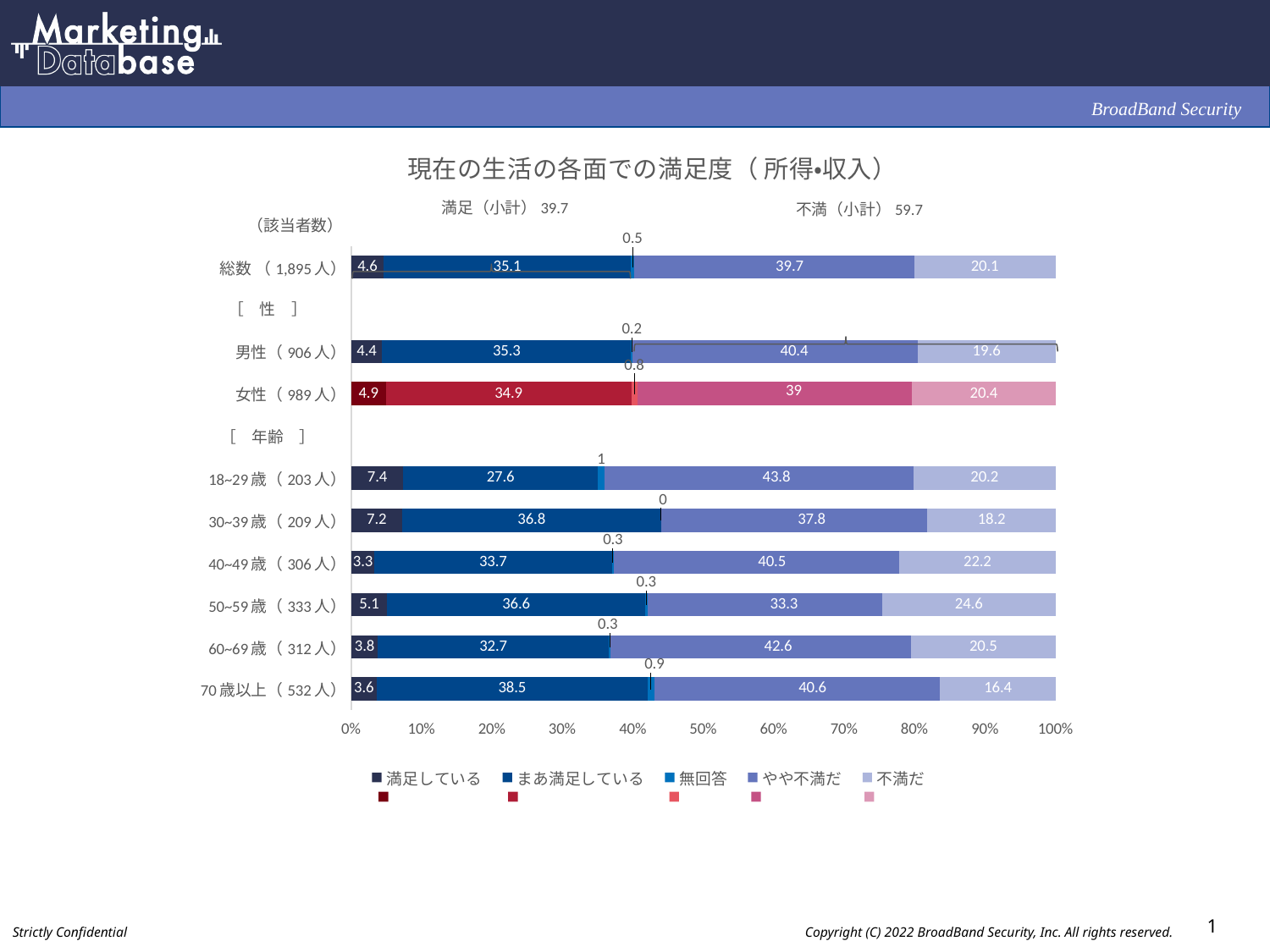
What is the value of 満足している for 18~29歳? 7.4 What is the value of 不満だ for 50~59歳? 24.6 Which category has the highest value for 満足している? 18~29歳 What is the value of まあ満足している for 70歳以上? 38.5 What is the title of the chart? 現在の生活の各面での満足度（所得・収入） Which category has the lowest value for 不満だ? 70歳以上 What is the value of やや不満だ for 総数? 39.7 What is the difference between the やや不満だ values for 男性 and 女性? 1.4 How many series does the legend list? 5 What kind of chart is shown on the slide? Stacked bar chart How many categories (bars) are plotted in the chart? 9 Which is larger, the まあ満足している value for 30~39歳 or for 60~69歳? 30~39歳